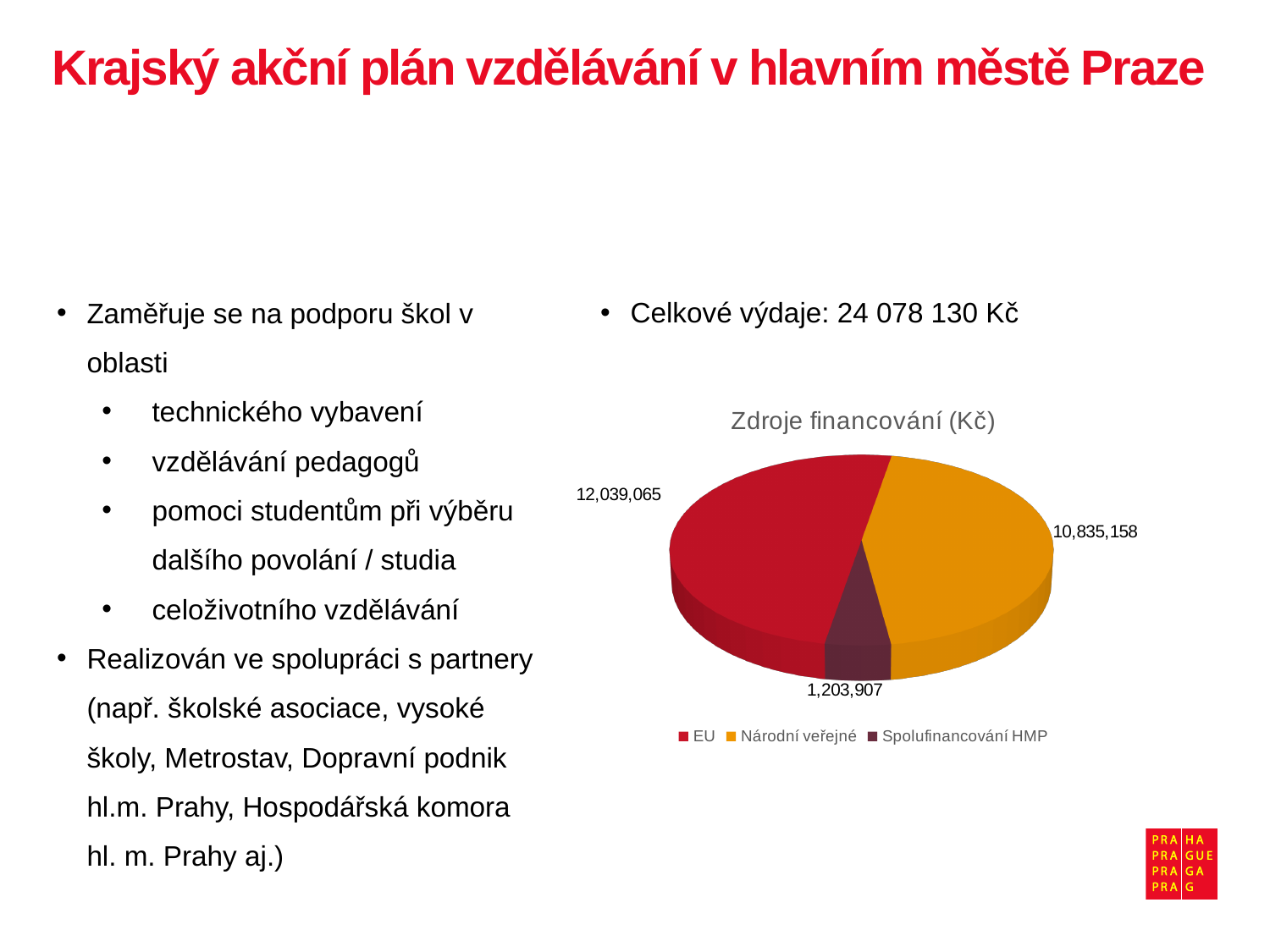
What type of chart is shown on the slide? pie chart What is the title of the chart? Zdroje financování (Kč) Which funding source has the smallest slice in the chart? Spolufinancování HMP What is the difference between the EU value and the Národní veřejné value? 1,203,907 How many series does the chart legend list? 3 Which is larger, the value for Národní veřejné or the value for Spolufinancování HMP? Národní veřejné What share of the pie does the EU slice represent? 50% How many slices does the pie chart have? 3 What is the value for Národní veřejné in the chart? 10,835,158 Which funding source has the largest slice in the chart? EU What is the value for EU in the chart? 12,039,065 What is the value for Spolufinancování HMP in the chart? 1,203,907